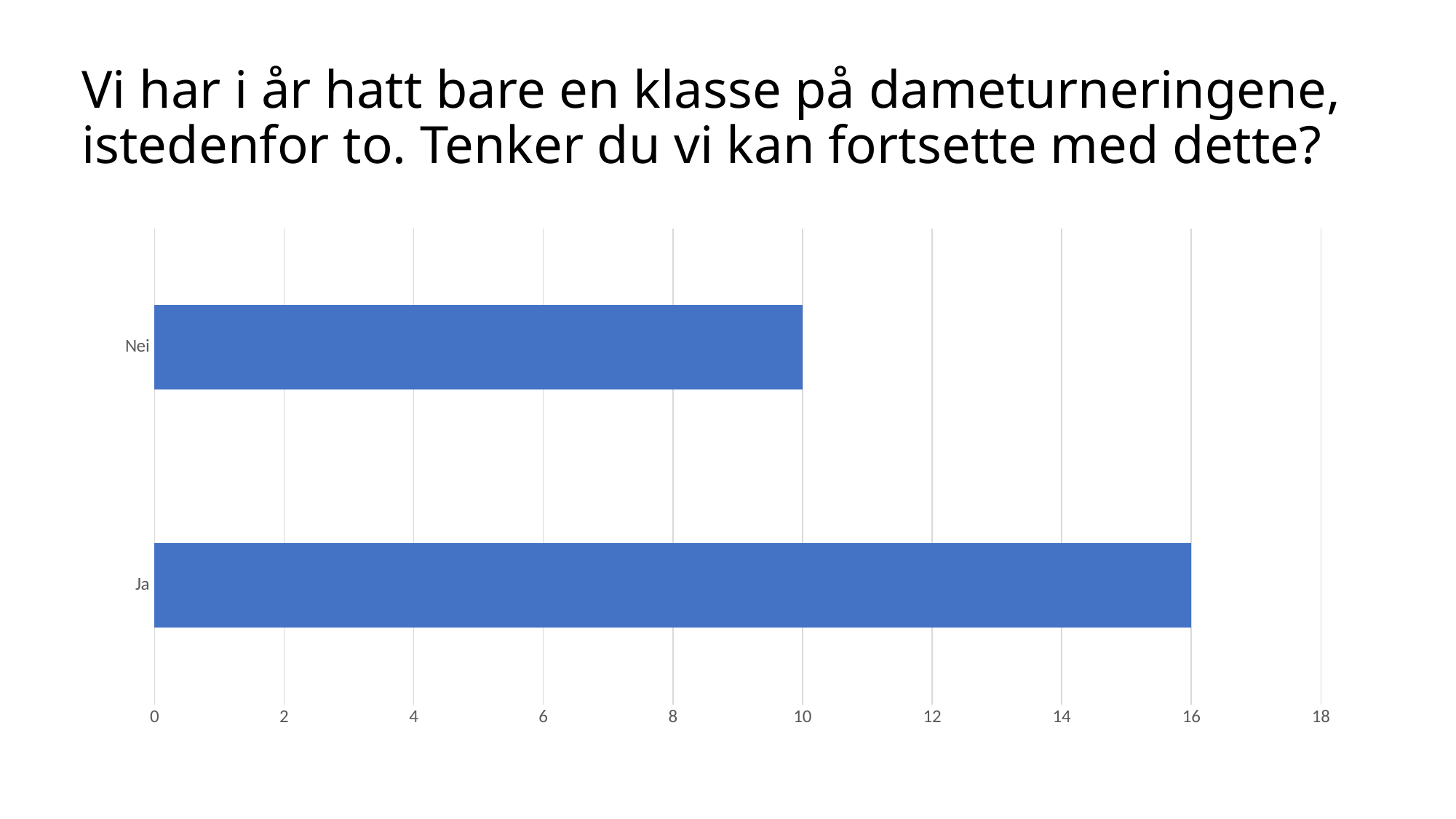
Is the value for Ja greater or less than 14? greater What is the difference between the values for Ja and Nei? 6 Which category has the highest value? Ja What colour are the bars in the chart? blue Which category has the lowest value? Nei What is the value for Nei? 10 What kind of chart is shown on the slide? bar chart What is the value for Ja? 16 Which is larger, the value for Ja or the value for Nei? Ja How many categories are shown in the chart? 2 What is the highest value shown on the horizontal axis? 18 Is the value for Nei greater or less than 12? less